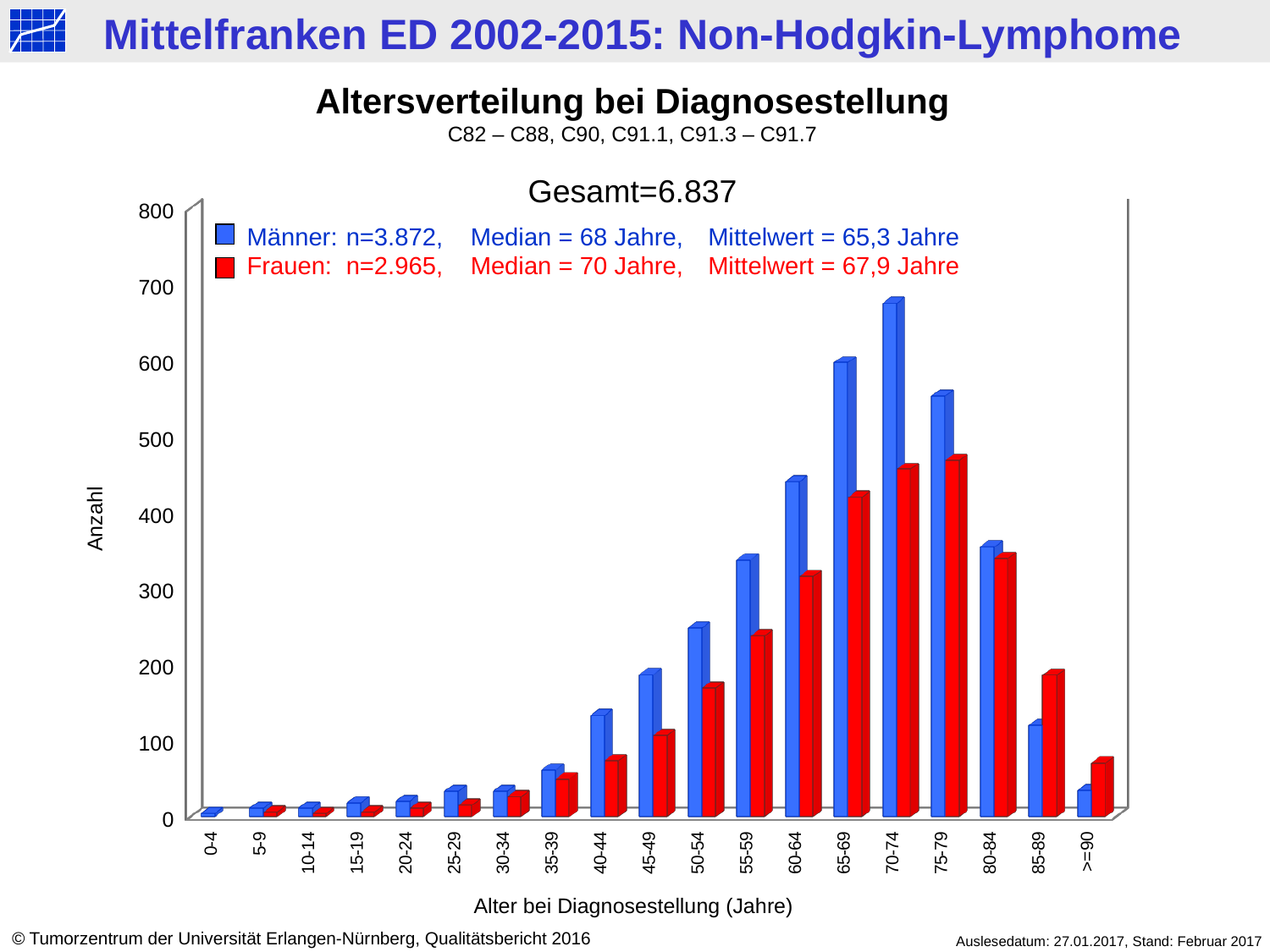
In the 85-89 age group, which is larger, the Männer bar or the Frauen bar? Frauen What is the median age for Frauen given in the legend? 70 Jahre Is the value for Frauen in the 40-44 age group greater or less than 100? less What kind of chart is shown on the slide? bar chart What is the total number of cases (Gesamt) given on the chart? 6.837 What is the Mittelwert for Männer given in the legend? 65,3 Jahre What is the n value for Männer given in the legend? 3.872 How many series does the legend list? 2 How many age categories are shown on the x axis? 19 In which age group is the Männer bar highest? 70-74 Is the value for Männer in the 70-74 age group greater or less than 600? greater Which colour represents Frauen in the chart? red